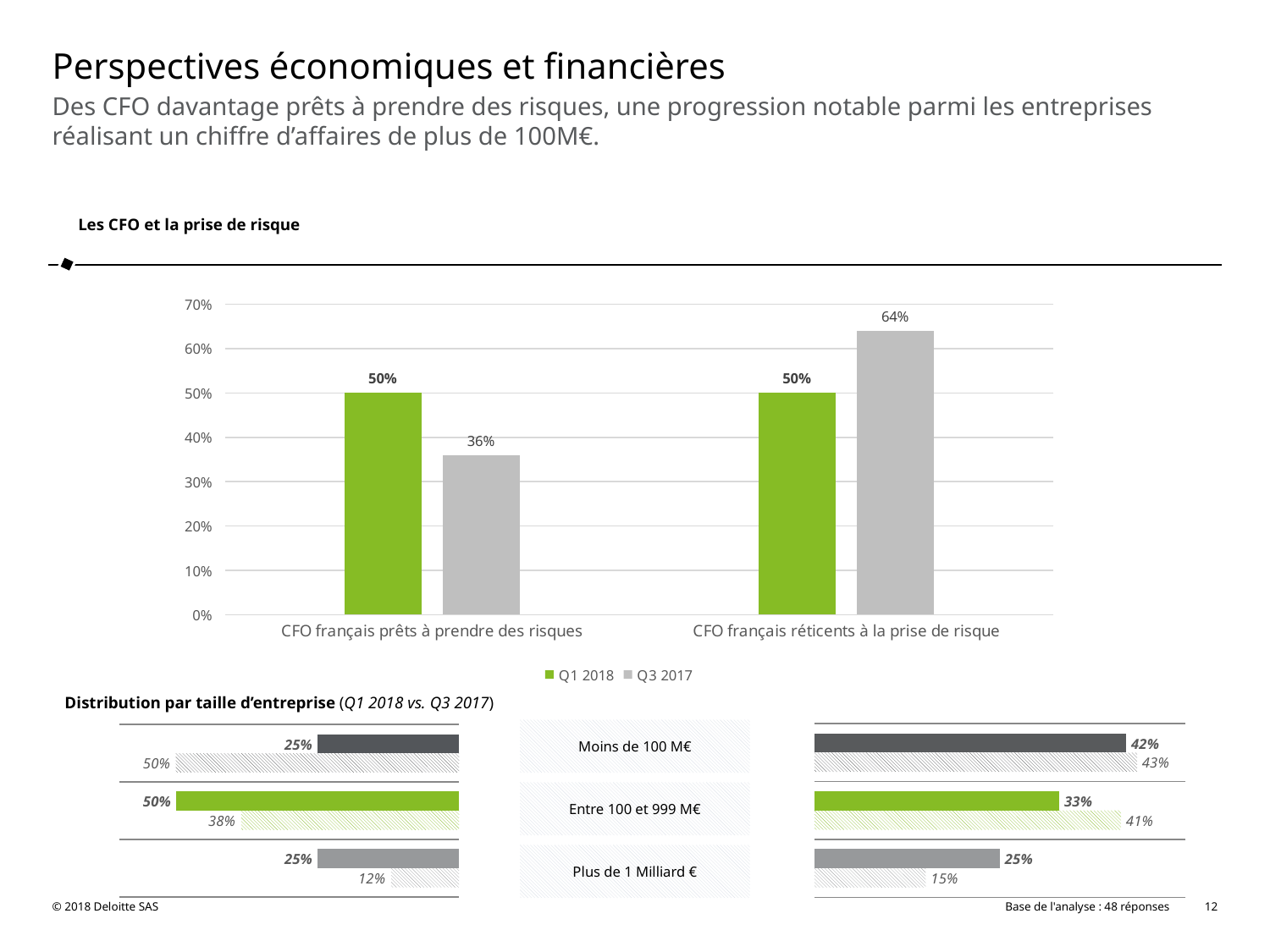
What kind of chart is 'Les CFO et la prise de risque'? Bar chart In the chart 'Les CFO et la prise de risque', for 'CFO français prêts à prendre des risques', which is larger: Q1 2018 or Q3 2017? Q1 2018 In the 'Distribution par taille d'entreprise' section, what is the Q3 2017 value for 'Plus de 1 Milliard €' in the right-hand chart (CFO réticents à la prise de risque)? 15% In the chart 'Les CFO et la prise de risque', which series is shown in green? Q1 2018 In the chart 'Les CFO et la prise de risque', what is the difference between the Q3 2017 and Q1 2018 values for 'CFO français réticents à la prise de risque'? 14 percentage points How many series does the legend of the chart 'Les CFO et la prise de risque' list? 2 In the chart 'Les CFO et la prise de risque', what is the Q1 2018 value for 'CFO français prêts à prendre des risques'? 50% In the chart 'Les CFO et la prise de risque', which bar is the highest? Q3 2017, CFO français réticents à la prise de risque (64%) In the chart 'Les CFO et la prise de risque', which bar is the lowest? Q3 2017, CFO français prêts à prendre des risques (36%) In the 'Distribution par taille d'entreprise' section, what is the Q1 2018 value for 'Entre 100 et 999 M€' in the left-hand chart (CFO prêts à prendre des risques)? 50% In the chart 'Les CFO et la prise de risque', what is the Q3 2017 value for 'CFO français réticents à la prise de risque'? 64% In the chart 'Les CFO et la prise de risque', what is the Q3 2017 value for 'CFO français prêts à prendre des risques'? 36%